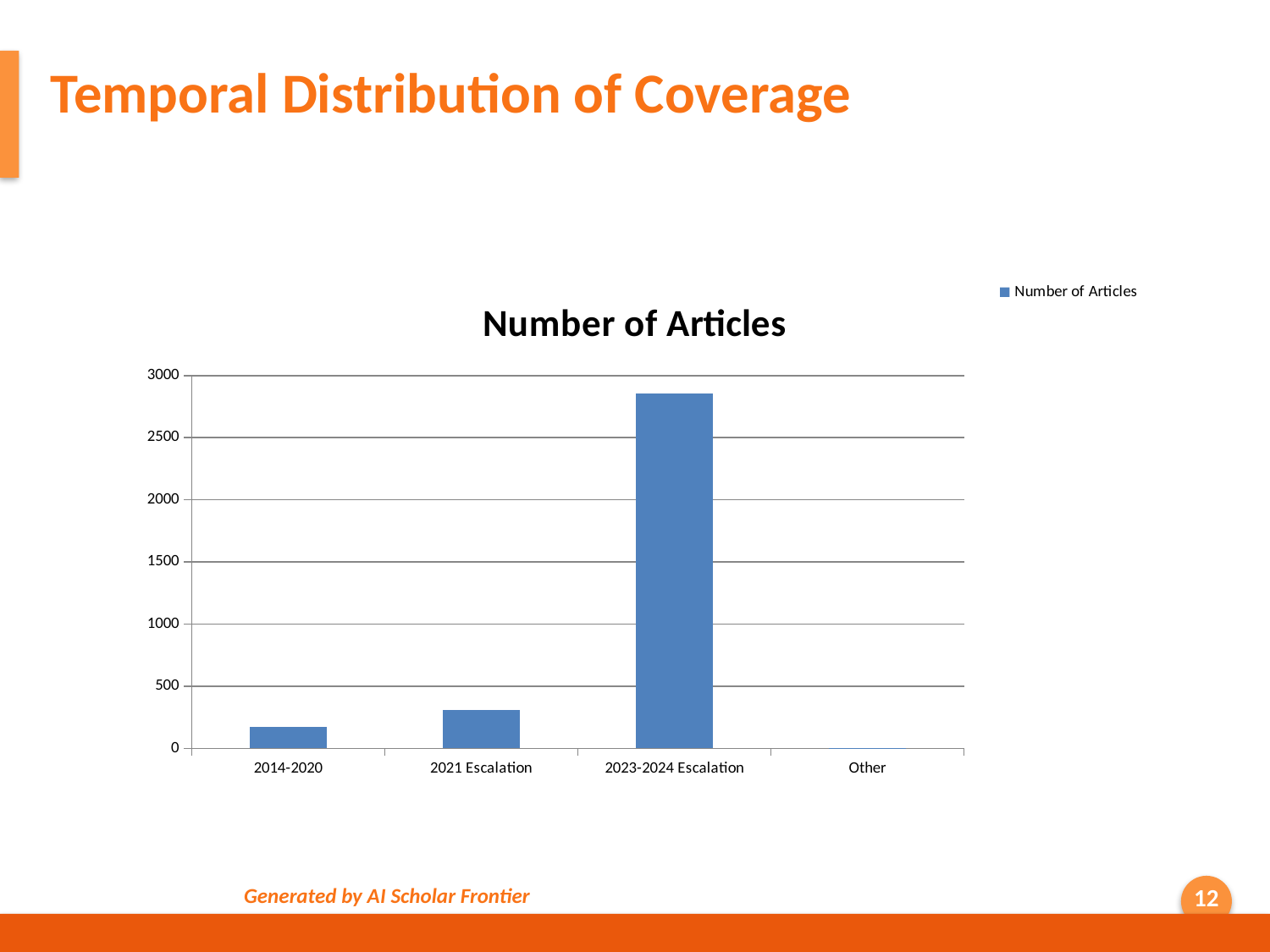
Is the value for 2021 Escalation greater or less than 500? less Which category has the lowest number of articles? Other What is the name of the series shown in the legend? Number of Articles Which has more articles, 2021 Escalation or 2014-2020? 2021 Escalation Is the value for 2023-2024 Escalation greater or less than 2500? greater Which has more articles, 2023-2024 Escalation or 2021 Escalation? 2023-2024 Escalation How many series does the legend list? 1 Which category has the highest number of articles? 2023-2024 Escalation What kind of chart is shown on the slide? bar chart How many categories are shown on the x axis of the chart? 4 Is the value for 2014-2020 greater or less than 500? less What is the title of the chart? Number of Articles